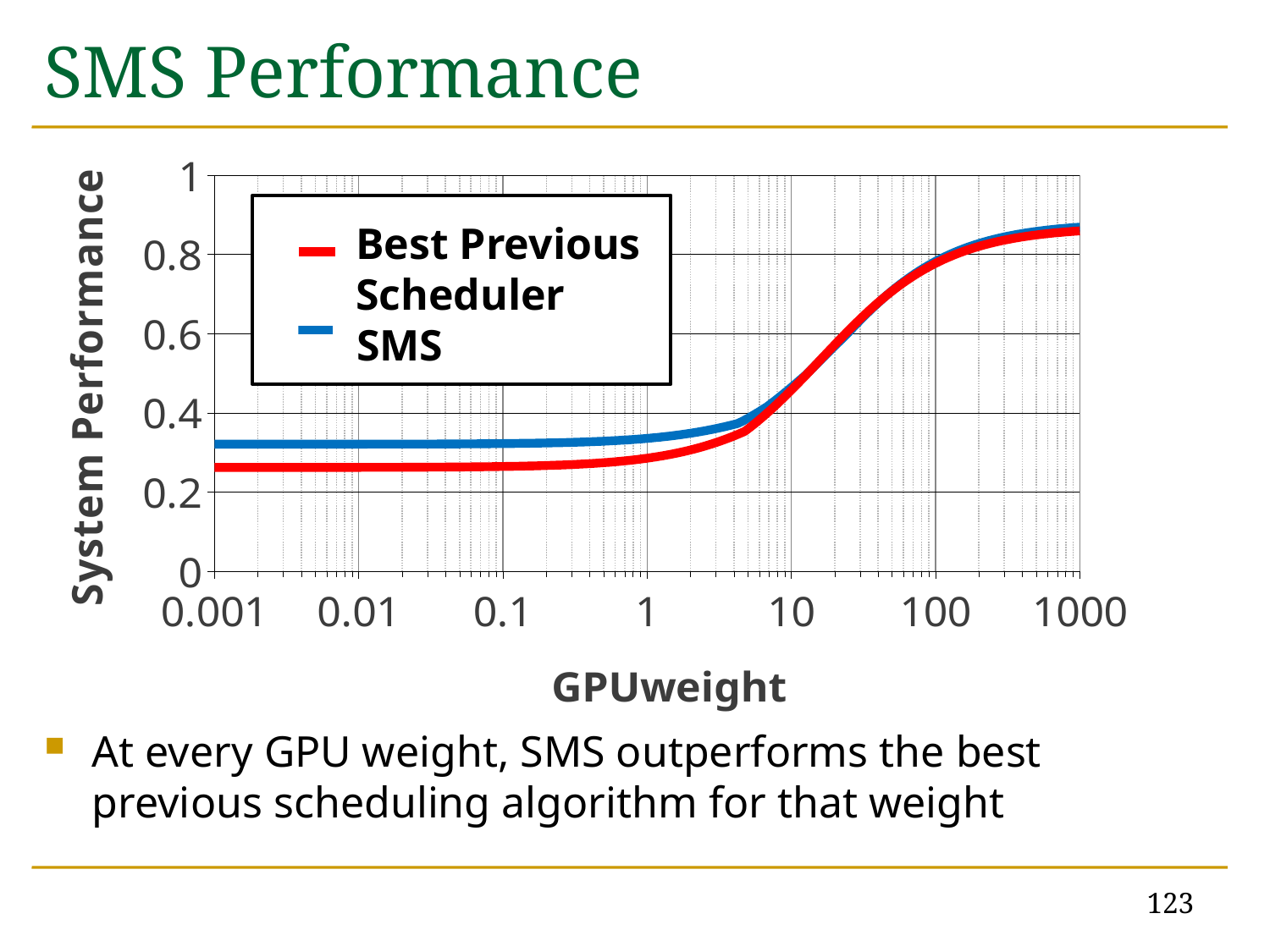
Do the System Performance values for Best Previous Scheduler rise or fall as GPUweight increases? rise At a GPUweight of 1, which series has the higher System Performance, SMS or Best Previous Scheduler? SMS Is the System Performance for Best Previous Scheduler at a GPUweight of 1 greater or less than 0.4? less At a GPUweight of 0.001, which series has the higher System Performance, SMS or Best Previous Scheduler? SMS Is the System Performance for SMS at a GPUweight of 0.001 greater or less than 0.4? less Do the System Performance values for SMS rise or fall as GPUweight increases? rise How many series does the legend list? 2 Which series is plotted in blue? SMS What is the title of the x axis? GPUweight Is the System Performance for Best Previous Scheduler at a GPUweight of 0.001 greater or less than 0.2? greater What kind of chart is shown on the slide? line chart